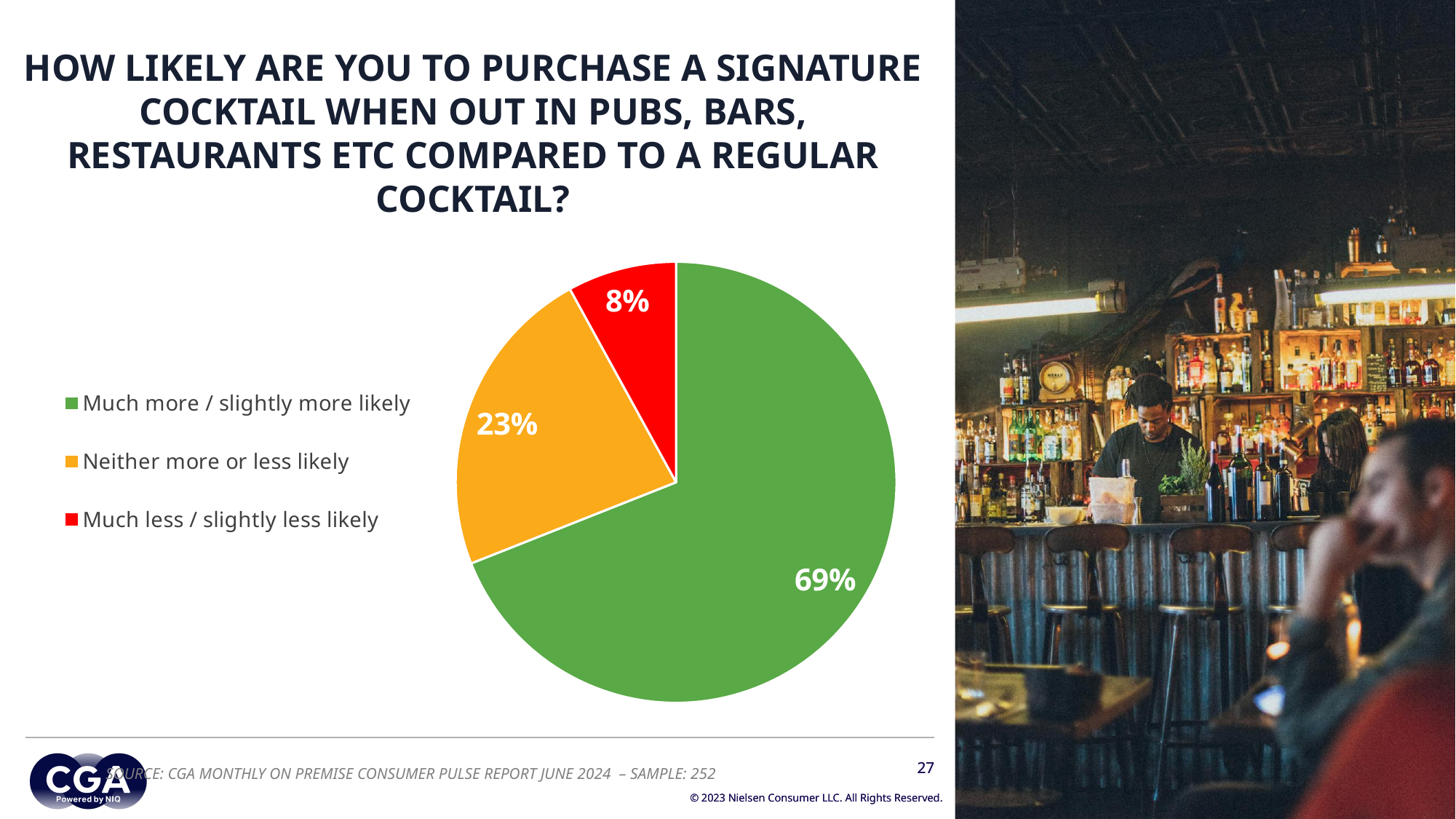
What percentage of respondents said they are neither more or less likely? 23% What percentage of respondents said they are much more / slightly more likely to purchase a signature cocktail? 69% What is the sample size stated in the source note below the chart? 252 What is the difference in percentage points between 'Much more / slightly more likely' and 'Neither more or less likely'? 46 percentage points How many categories does the pie chart show? 3 What kind of chart is shown on the slide? Pie chart What is the difference in percentage points between 'Neither more or less likely' and 'Much less / slightly less likely'? 15 percentage points What colour is the slice for 'Much less / slightly less likely'? Red What percentage of respondents said they are much less / slightly less likely? 8% Which response category has the smallest share of the pie? Much less / slightly less likely Which response category has the largest share of the pie? Much more / slightly more likely Which is larger: the share for 'Neither more or less likely' or the share for 'Much less / slightly less likely'? Neither more or less likely